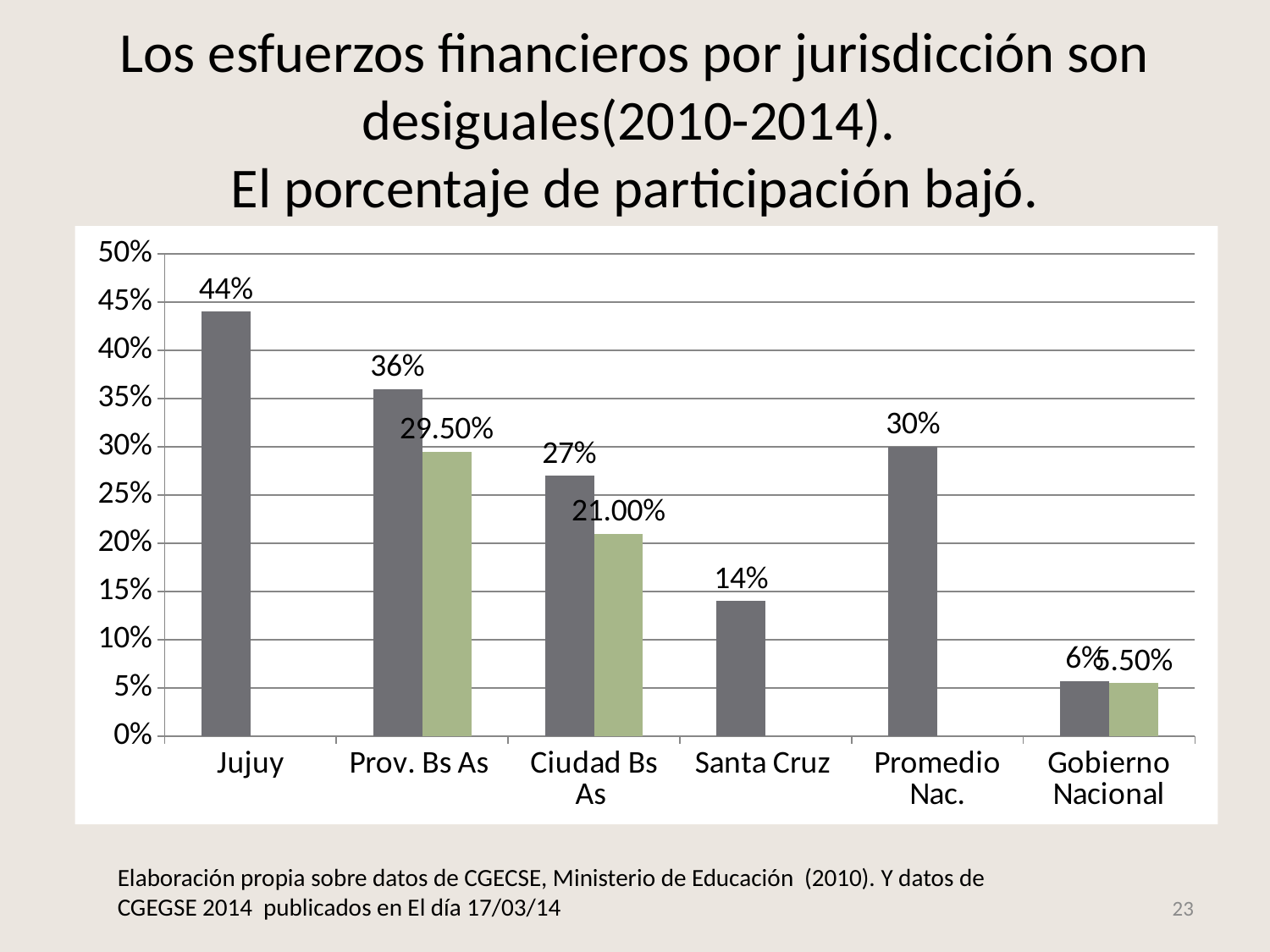
What is the value of the gray bar for Promedio Nac.? 30% How many categories are shown on the x axis? 6 What is the value of the gray bar for Jujuy? 44% What is the value of the green bar for Ciudad Bs As? 21.00% What is the difference between the gray bar for Jujuy and the gray bar for Santa Cruz? 30% Which category has the highest gray bar? Jujuy Which category has the lowest gray bar? Gobierno Nacional What is the value of the green bar for Prov. Bs As? 29.50% What is the value of the gray bar for Santa Cruz? 14% What kind of chart is shown on the slide? Bar chart Which is larger: the gray bar for Prov. Bs As or the gray bar for Promedio Nac.? Prov. Bs As How many categories have both a gray and a green bar? 3